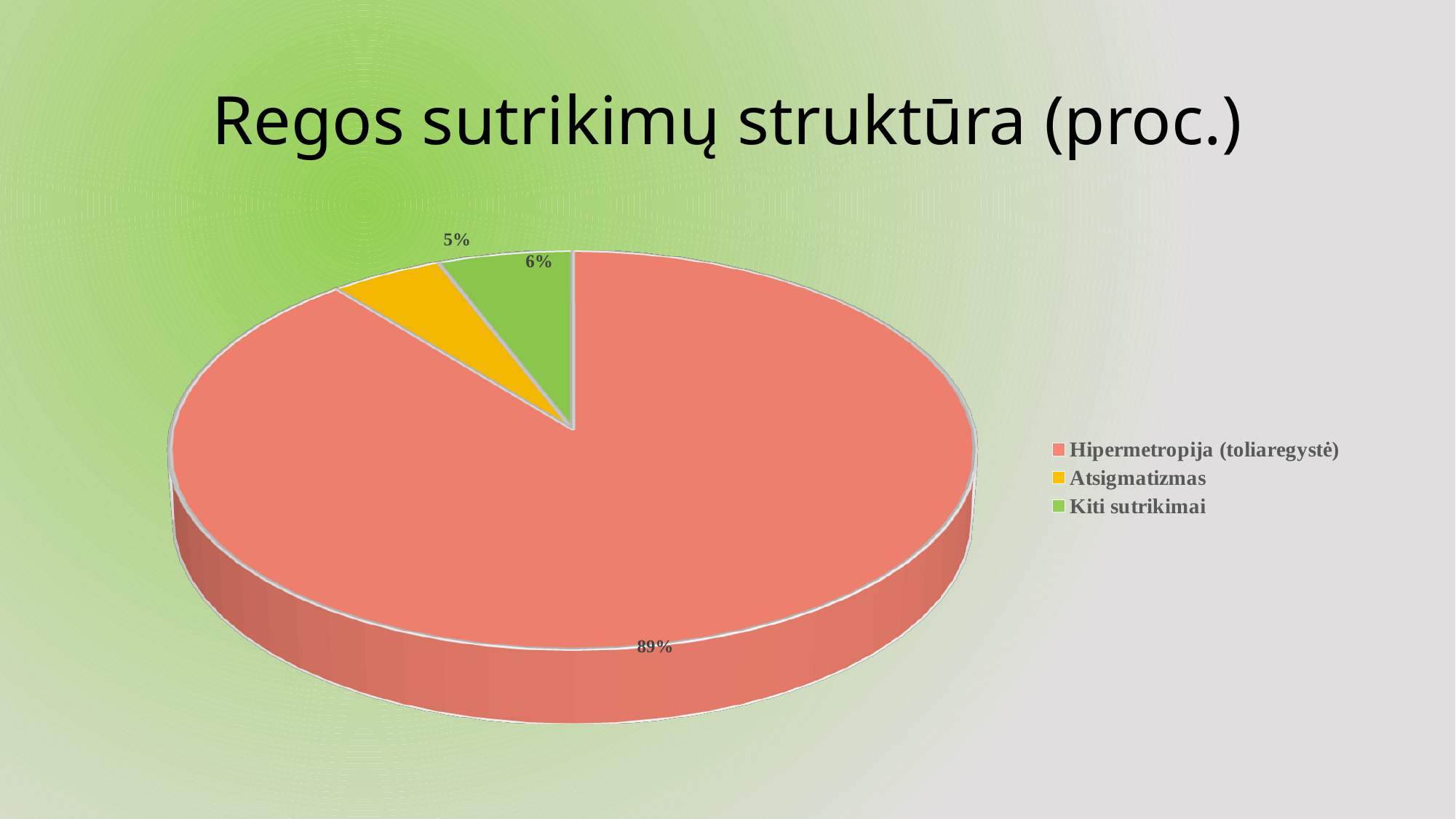
Which is larger, the slice for Atsigmatizmas or the slice for Kiti sutrikimai? Kiti sutrikimai What share of the pie does Atsigmatizmas have? 5% What kind of chart is shown on the slide? Pie chart What is the title of the chart? Regos sutrikimų struktūra (proc.) What share of the pie does Kiti sutrikimai have? 6% What is the difference in percentage points between Kiti sutrikimai and Atsigmatizmas? 1 How many categories are shown in the pie chart? 3 What is the difference in percentage points between Hipermetropija (toliaregystė) and Kiti sutrikimai? 83 Which category has the largest slice of the pie? Hipermetropija (toliaregystė) Which category has the smallest slice of the pie? Atsigmatizmas What share of the pie does Hipermetropija (toliaregystė) have? 89% What colour is the slice for Atsigmatizmas? Yellow